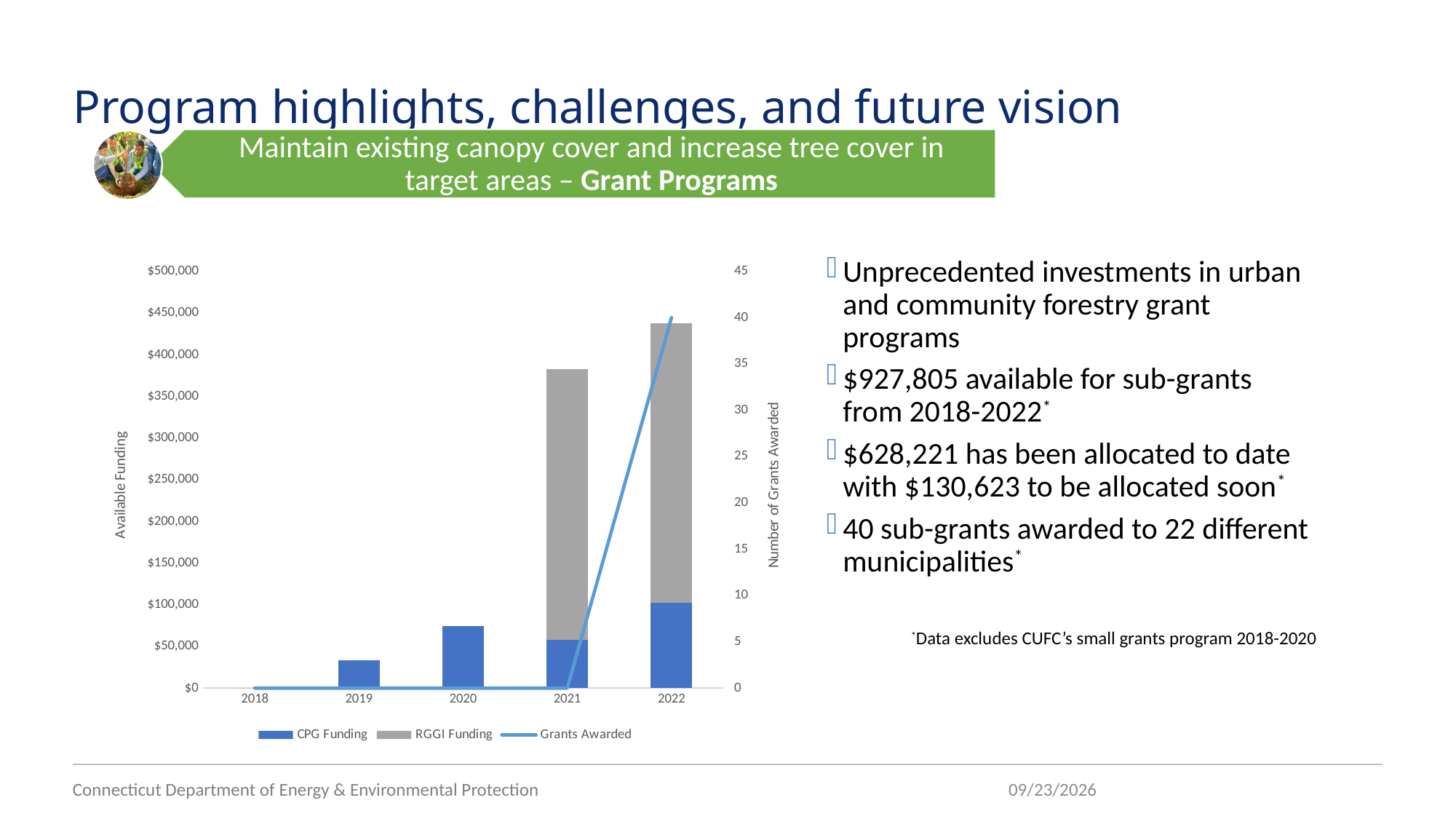
What kind of chart is shown on the slide? combination bar and line chart How many series does the chart legend list? 3 What is the title of the right-hand vertical axis? Number of Grants Awarded Is the CPG Funding value for 2022 greater or less than $150,000? less How many years are shown along the x axis of the chart? 5 Which year has the highest total available funding? 2022 Is the CPG Funding value for 2019 greater or less than $50,000? less Which year has the lowest total available funding? 2018 Which is larger, CPG Funding in 2022 or CPG Funding in 2019? CPG Funding in 2022 Does total available funding rise or fall from 2018 to 2022? rise What colour represents RGGI Funding in the chart? gray Is the total available funding for 2021 greater or less than $350,000? greater